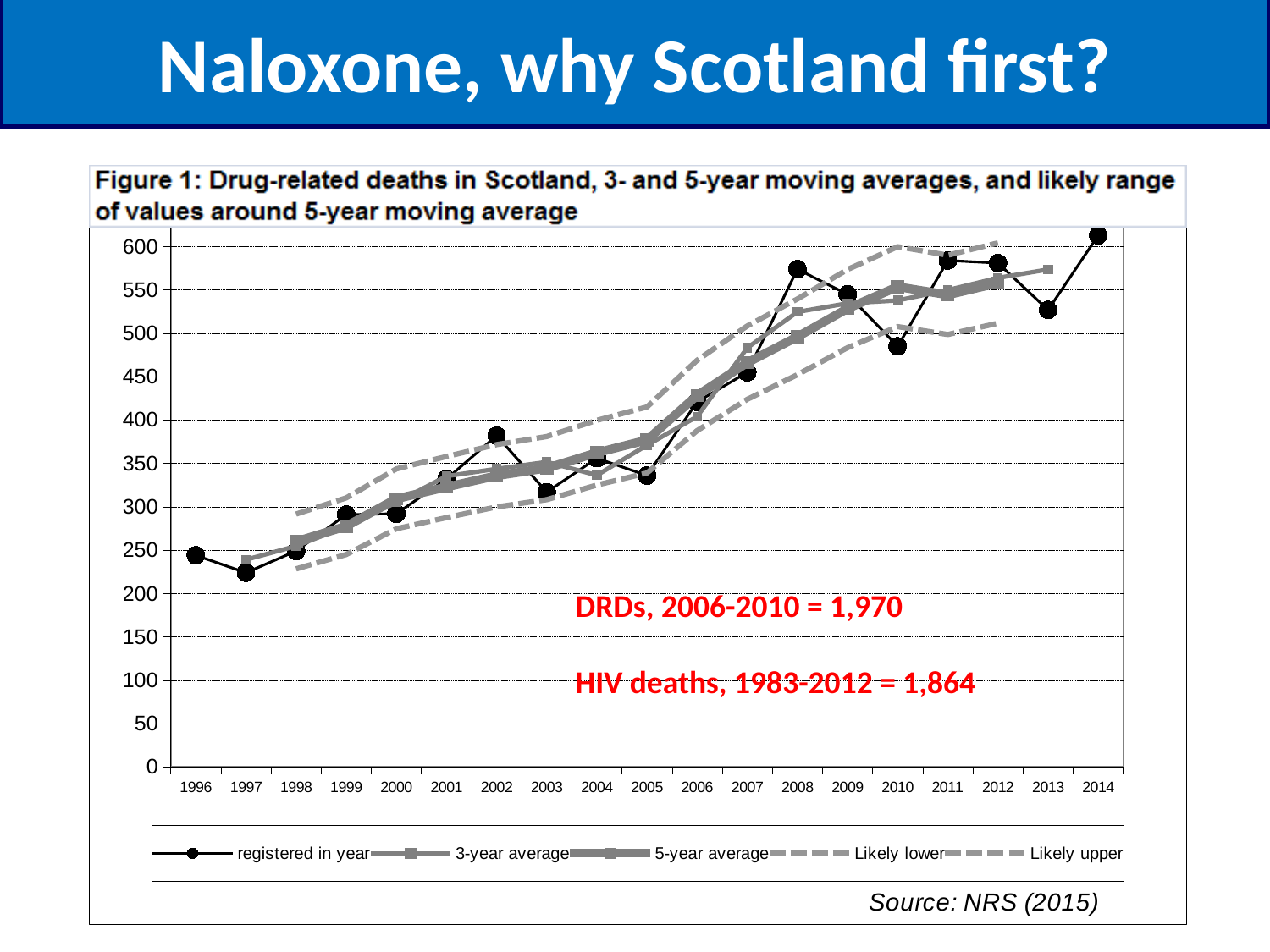
How many years are shown on the x axis? 19 Is the 'registered in year' value for 1997 greater or less than 250? less Which year has the larger 'registered in year' value, 2008 or 2010? 2008 How many series does the legend list? 5 In which year is the 'registered in year' value highest? 2014 Is the 'registered in year' value for 2010 greater or less than 500? less Overall, do the 'registered in year' values rise or fall from 1996 to 2014? rise What is the source cited below the chart? NRS (2015) In which year is the 'registered in year' value lowest? 1997 Is the 'registered in year' value for 2008 greater or less than 550? greater What kind of chart is shown on the slide? line chart